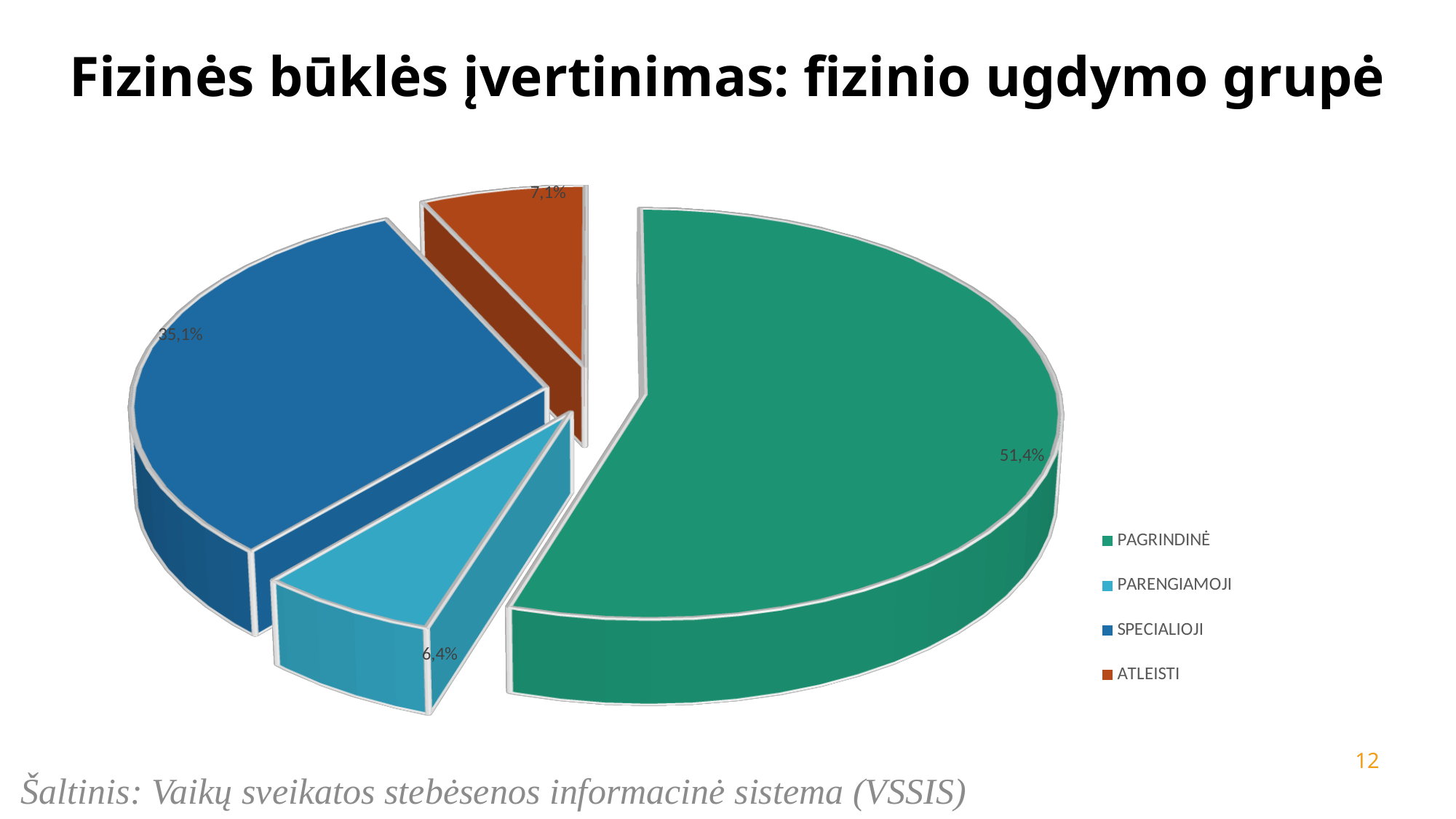
What type of chart is shown on the slide? Pie chart What is the difference in percentage points between the PAGRINDINĖ and SPECIALIOJI slices? 16,3% Which slice is larger, ATLEISTI or PARENGIAMOJI? ATLEISTI What percentage of the pie does the PAGRINDINĖ slice represent? 51,4% Which category has the smallest share of the pie? PARENGIAMOJI What percentage is shown for the SPECIALIOJI slice? 35,1% What percentage is shown for the ATLEISTI slice? 7,1% What value is labelled on the PARENGIAMOJI slice? 6,4% Which category has the largest share of the pie? PAGRINDINĖ How many slices does the pie chart have? 4 What is the difference between the ATLEISTI and PARENGIAMOJI shares? 0,7% Which legend entry is shown in orange? ATLEISTI